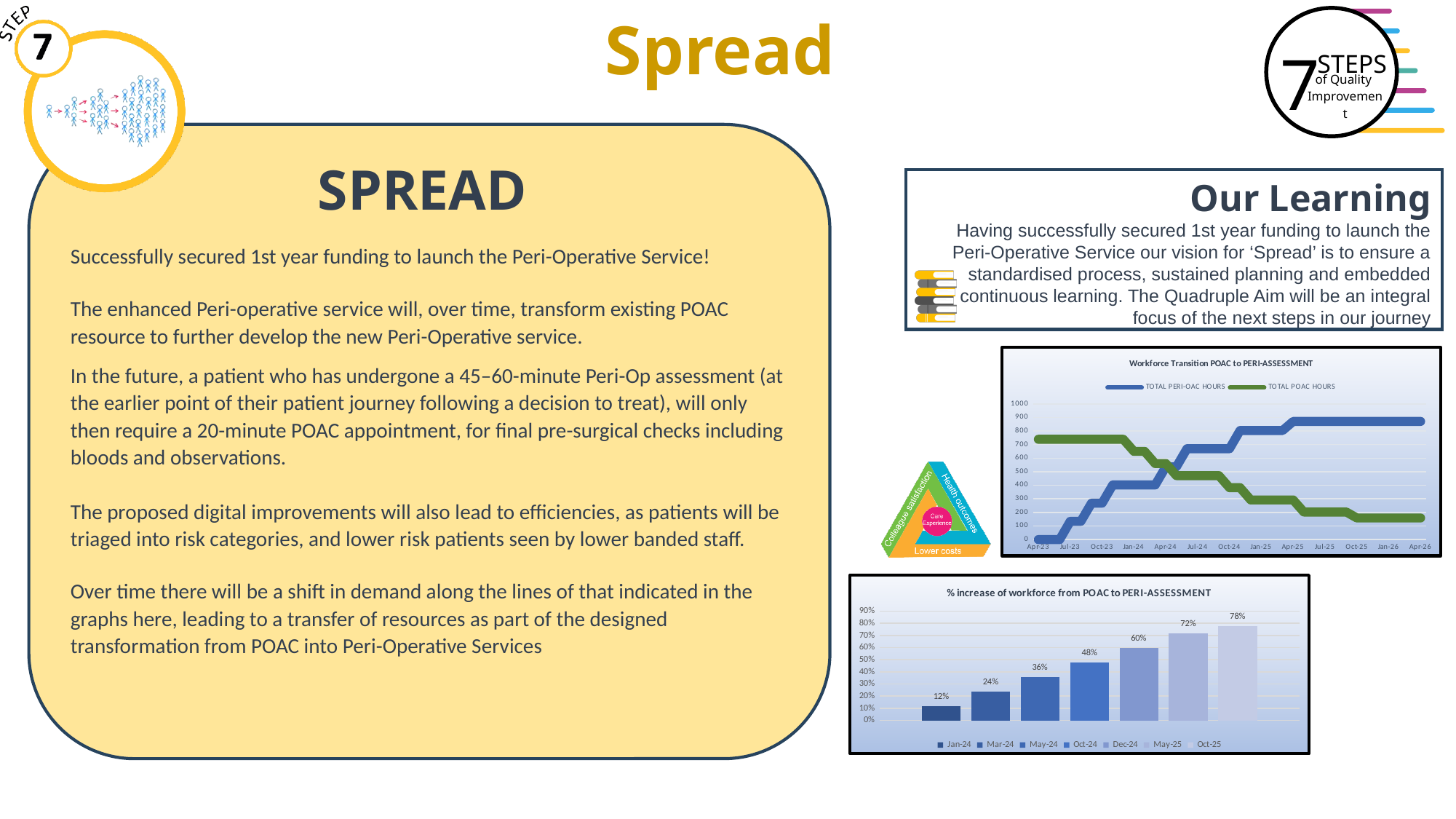
In the '% increase of workforce from POAC to PERI-ASSESSMENT' chart, which category has the lowest value? Jan-24 In the 'Workforce Transition POAC to PERI-ASSESSMENT' chart, is the value for TOTAL POAC HOURS at Apr-26 greater or less than 200? less How many series does the legend of the 'Workforce Transition POAC to PERI-ASSESSMENT' chart list? 2 In the '% increase of workforce from POAC to PERI-ASSESSMENT' chart, which category has the highest value? Oct-25 In the '% increase of workforce from POAC to PERI-ASSESSMENT' chart, what is the value for May-24? 36% In the '% increase of workforce from POAC to PERI-ASSESSMENT' chart, how many bars are plotted? 7 What kind of chart is the 'Workforce Transition POAC to PERI-ASSESSMENT' chart? line chart In the '% increase of workforce from POAC to PERI-ASSESSMENT' chart, do the values rise or fall from Jan-24 to Oct-25? rise In the '% increase of workforce from POAC to PERI-ASSESSMENT' chart, what is the difference between the values for Dec-24 and Oct-24? 12% In the '% increase of workforce from POAC to PERI-ASSESSMENT' chart, what is the value for Oct-25? 78% What kind of chart is the '% increase of workforce from POAC to PERI-ASSESSMENT' chart? bar chart In the 'Workforce Transition POAC to PERI-ASSESSMENT' chart, is the value for TOTAL PERI-OAC HOURS at Apr-26 greater or less than 800? greater